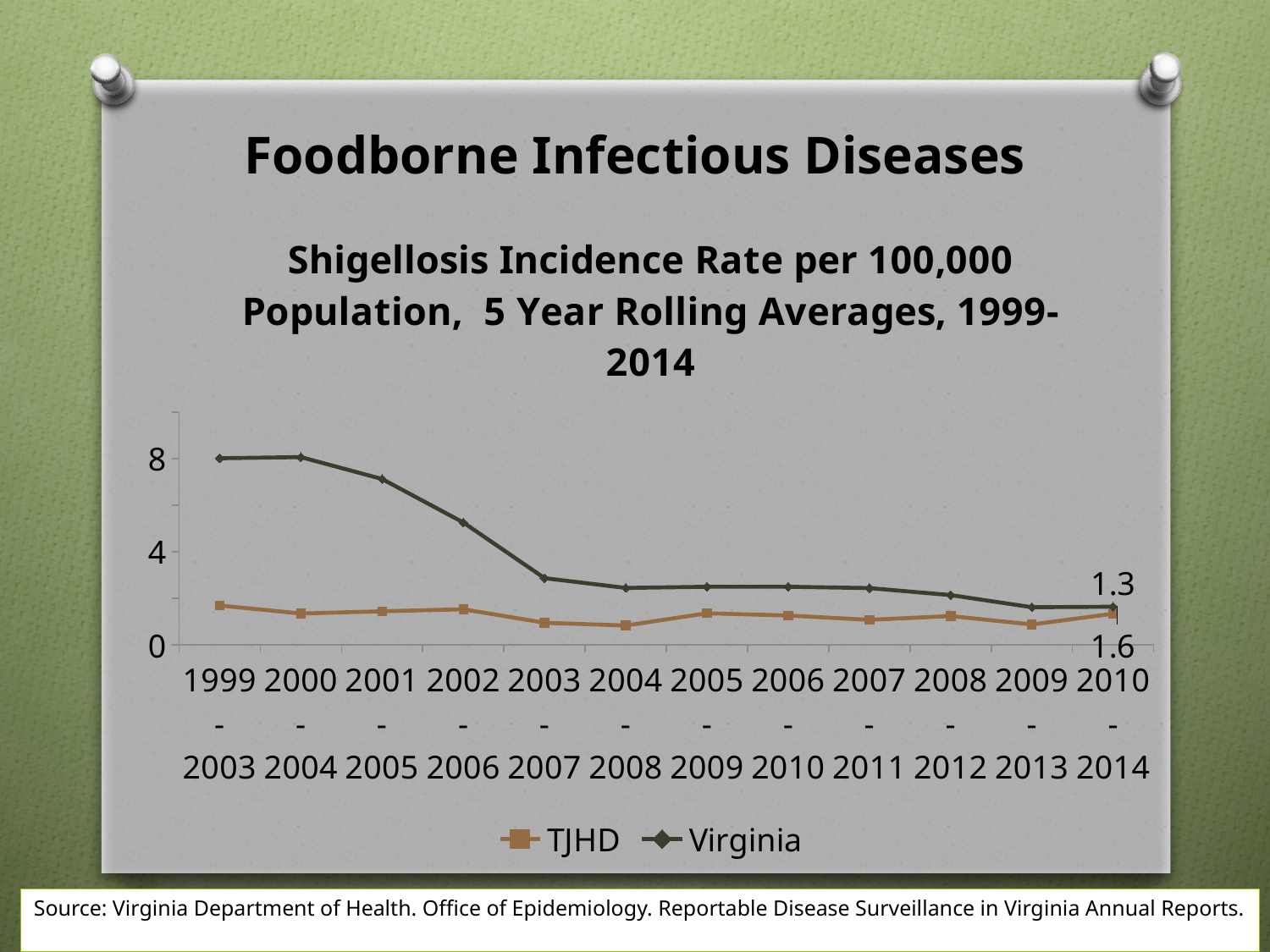
What are the two series named in the legend? TJHD and Virginia How many 5-year periods are plotted along the x axis? 12 Which series has the higher value for 1999-2003, TJHD or Virginia? Virginia How many series does the legend list? 2 Which two values are printed as data labels at the 2010-2014 point? 1.3 and 1.6 Which series is plotted with the orange line? TJHD Is the Virginia value for 2003-2007 greater or less than 4? less What kind of chart is shown on the slide? line chart Is the Virginia value for 1999-2003 greater or less than 4? greater Is the TJHD value for 2002-2006 greater or less than 4? less Does the Virginia series generally rise or fall from 1999-2003 to 2010-2014? fall